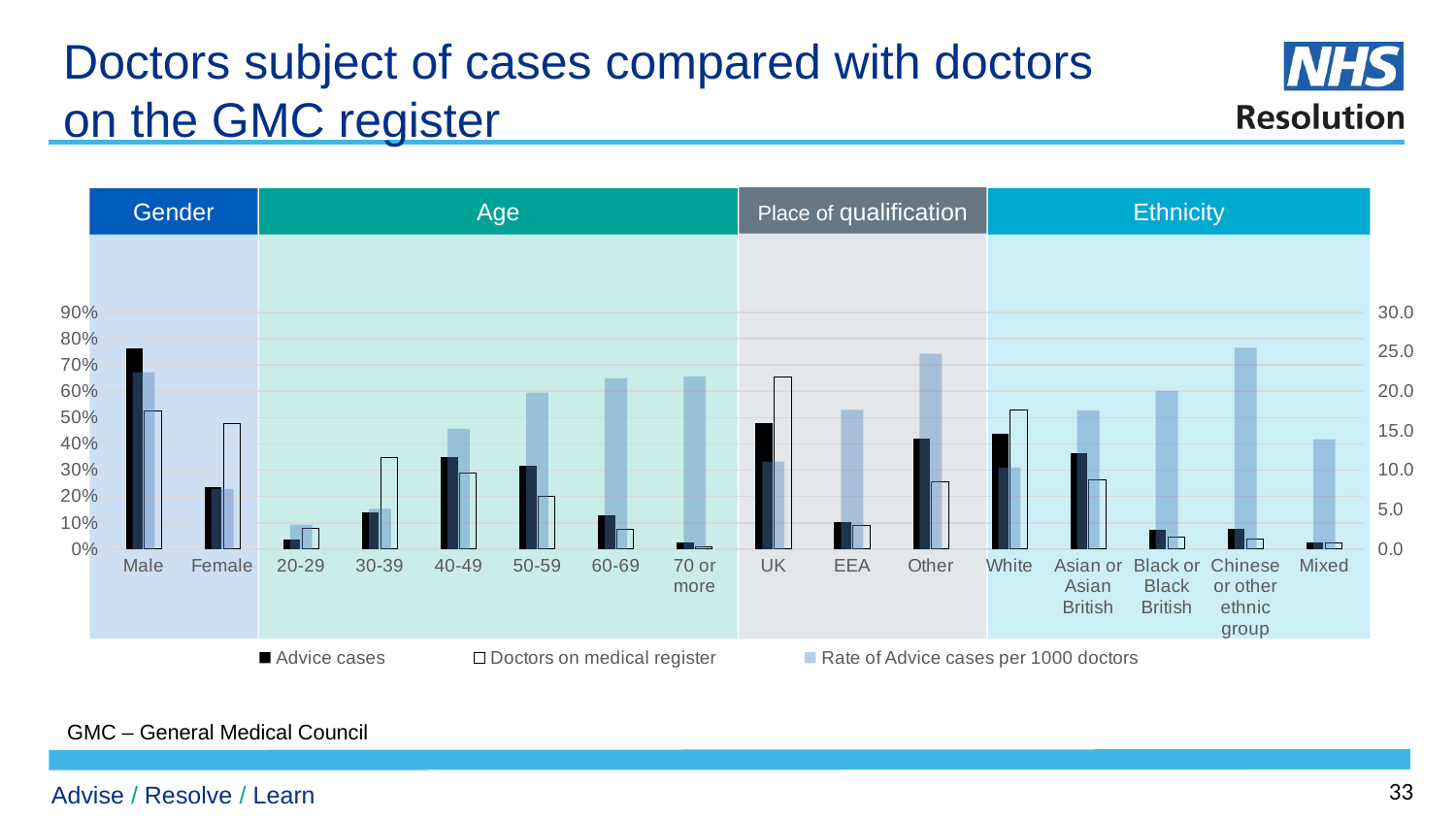
Is the Advice cases value for Male greater or less than 70%? greater Is the Doctors on medical register value for Female greater or less than 40%? greater How many series does the legend list? 3 Which has the larger Advice cases value: UK or Other? UK What kind of chart is shown on the slide? bar chart Is the Rate of Advice cases per 1000 doctors for Female greater or less than 10.0? less Which category has the highest value for Advice cases? Male For Female, which is larger: Advice cases or Doctors on medical register? Doctors on medical register How many categories are shown along the x axis of the chart? 16 What are the four group headings shown above the chart? Gender, Age, Place of qualification, Ethnicity